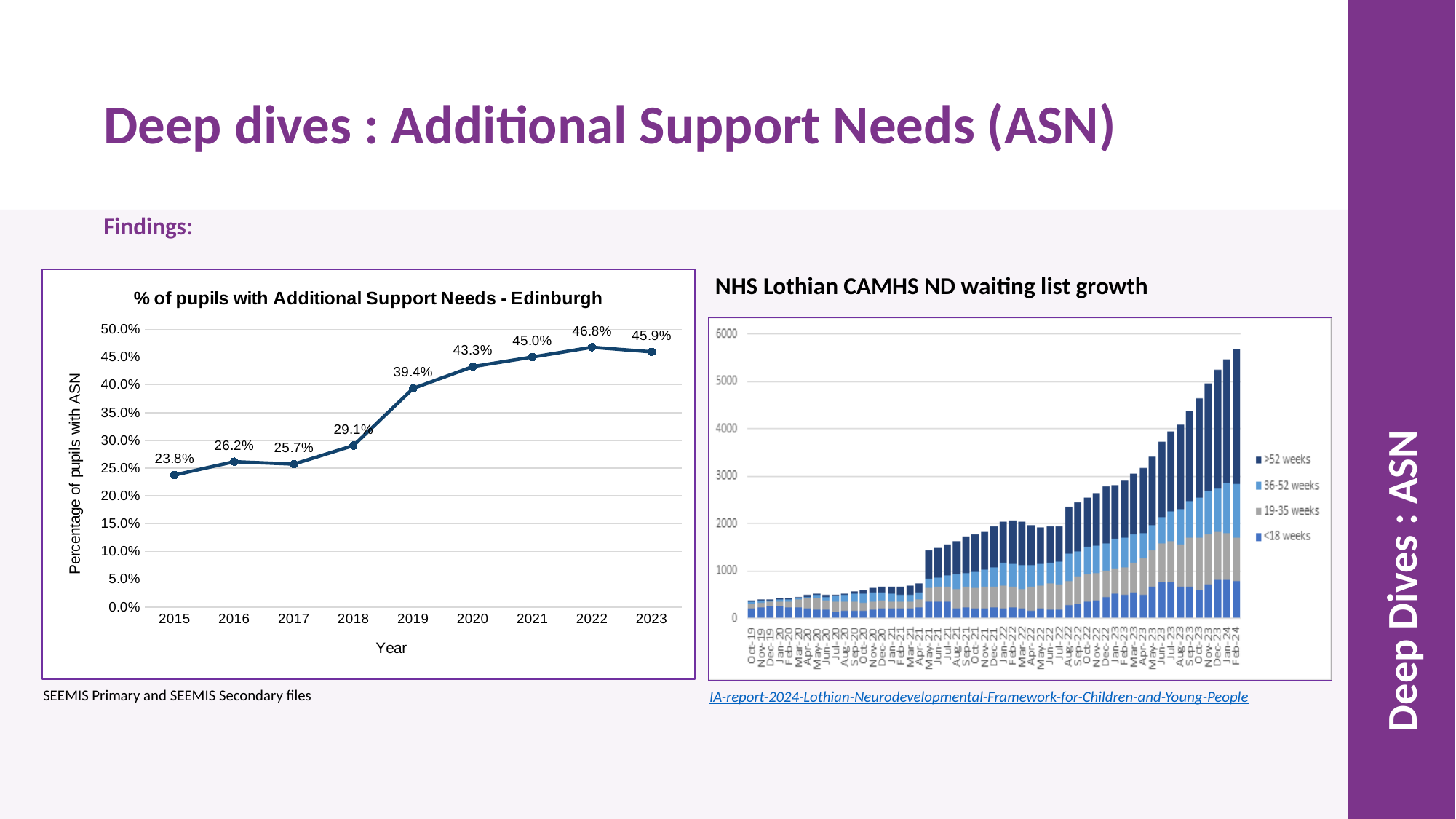
How many series does the legend list in the 'NHS Lothian CAMHS ND waiting list growth' chart? 4 In the '% of pupils with Additional Support Needs - Edinburgh' chart, which year has the lowest percentage? 2015 In the '% of pupils with Additional Support Needs - Edinburgh' chart, which is larger, the value for 2016 or the value for 2017? 2016 How many years are plotted in the '% of pupils with Additional Support Needs - Edinburgh' chart? 9 In the '% of pupils with Additional Support Needs - Edinburgh' chart, which year has the highest percentage? 2022 In the '% of pupils with Additional Support Needs - Edinburgh' chart, what is the value for 2023? 45.9% What kind of chart is the 'NHS Lothian CAMHS ND waiting list growth' chart? Stacked bar chart In the '% of pupils with Additional Support Needs - Edinburgh' chart, what is the value for 2019? 39.4% What kind of chart is the '% of pupils with Additional Support Needs - Edinburgh' chart? Line chart In the '% of pupils with Additional Support Needs - Edinburgh' chart, what is the difference between the 2019 and 2018 values? 10.3% In the '% of pupils with Additional Support Needs - Edinburgh' chart, do the values generally rise or fall from 2015 to 2022? Rise In the 'NHS Lothian CAMHS ND waiting list growth' chart, is the total for Feb-24 greater or less than 5000? greater